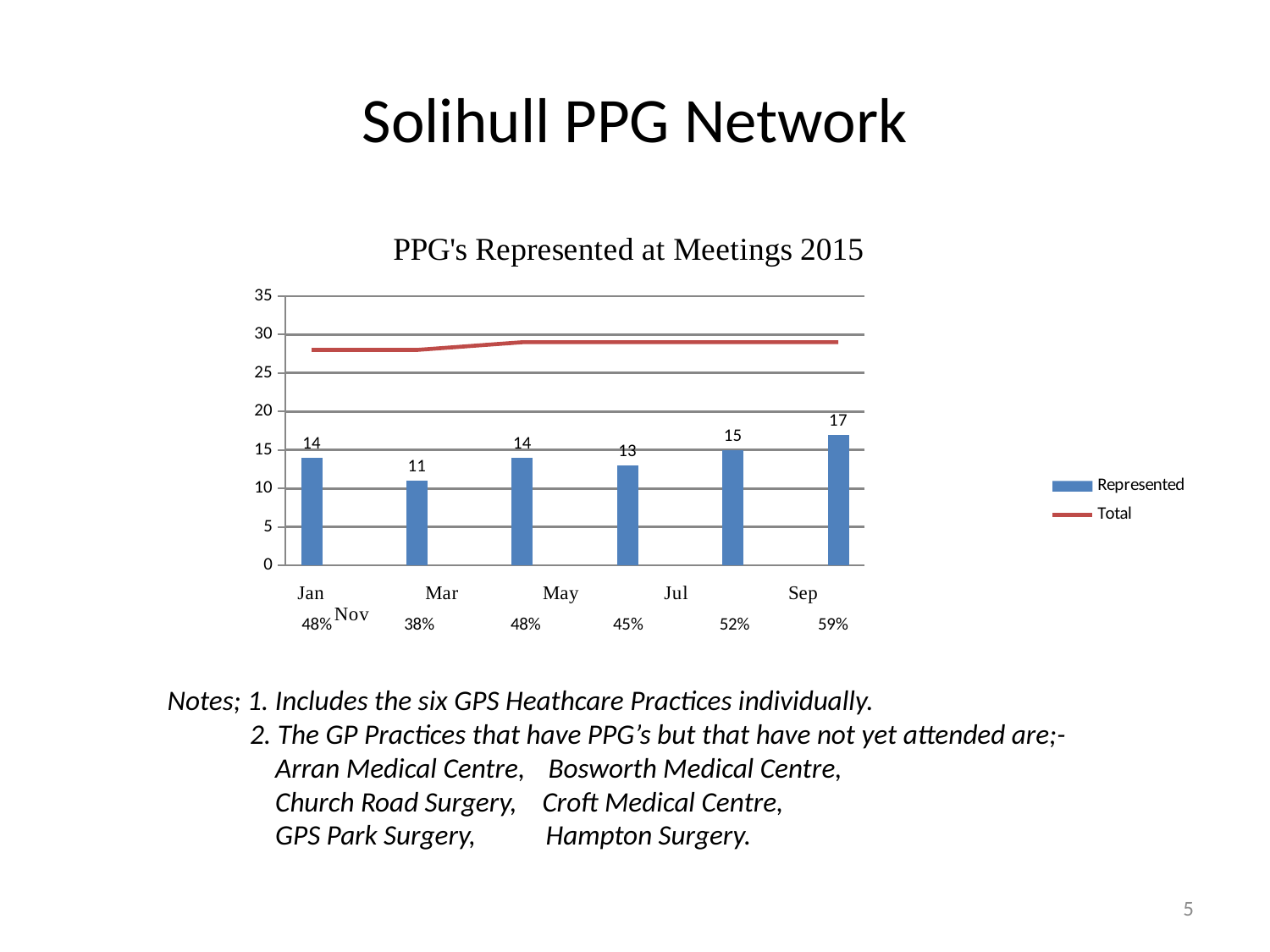
Is the value of the Total line for Jan greater or less than 25? greater What is the value of the Represented series for Mar? 11 Do the Represented values rise or fall from Jul to Nov? rise What is the difference between the Represented values for Nov and Mar? 6 How many months are shown on the x axis? 6 How many series does the legend list? 2 What kind of chart is used to show the Represented series? bar chart Which month has the larger Represented value, Sep or Jul? Sep What is the value of the Represented series for Jan? 14 What is the value of the Represented series for Nov? 17 Which month has the highest Represented value? Nov Which month has the lowest Represented value? Mar